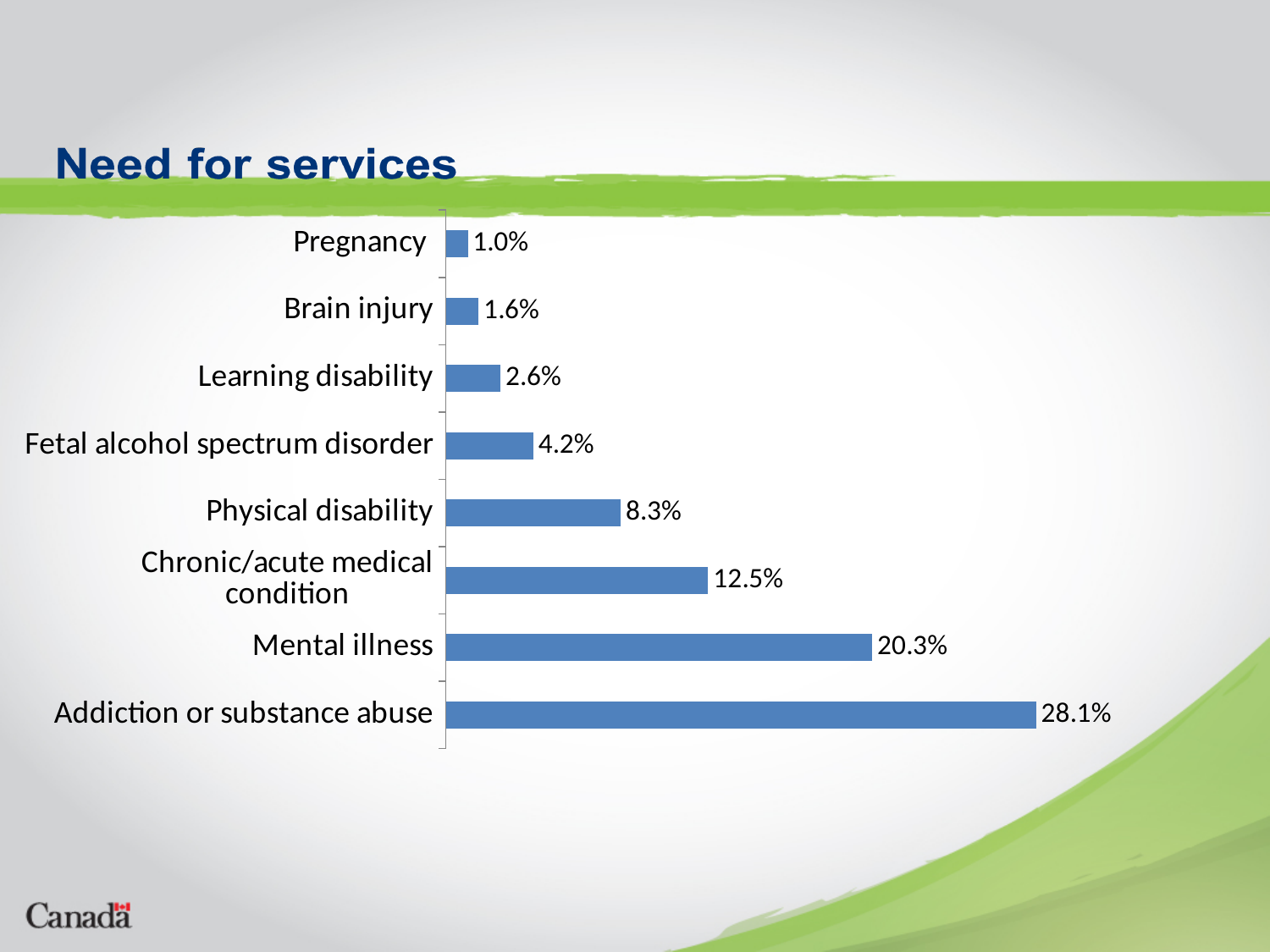
Which is larger, the value for Brain injury or the value for Learning disability? Learning disability What is the value for Mental illness? 20.3% What is the difference between the values for Addiction or substance abuse and Mental illness? 7.8% What is the value for Addiction or substance abuse? 28.1% What is the value for Pregnancy? 1.0% Which category has the lowest value? Pregnancy What is the value for Chronic/acute medical condition? 12.5% What is the value for Fetal alcohol spectrum disorder? 4.2% How many categories are shown in the chart? 8 What is the difference between the values for Physical disability and Learning disability? 5.7% Which category has the highest value? Addiction or substance abuse What kind of chart is shown on the slide? Bar chart